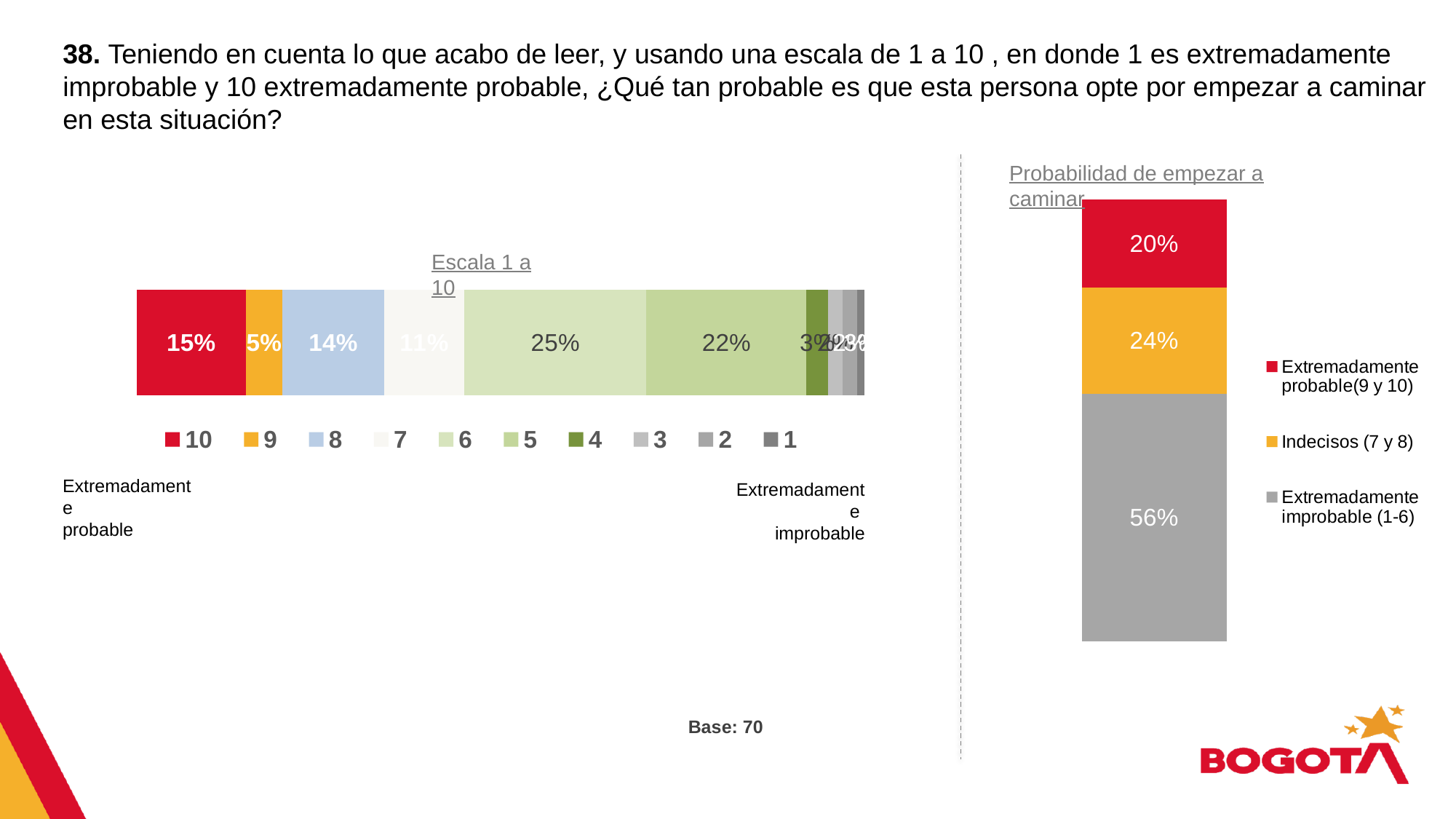
In the 'Probabilidad de empezar a caminar' chart, what percentage is 'Indecisos (7 y 8)'? 24% In the 'Probabilidad de empezar a caminar' chart, what is the difference between 'Indecisos (7 y 8)' and 'Extremadamente probable(9 y 10)'? 4% In the 'Escala 1 a 10' chart, what is the difference between the shares for 6 and 5? 3% What type of chart is the 'Probabilidad de empezar a caminar' chart? Stacked bar chart In the 'Escala 1 a 10' chart, which is larger, the share for 10 or the share for 9? 10 In the 'Escala 1 a 10' chart, what percentage is shown for the value 5? 22% How many entries does the legend of the 'Escala 1 a 10' chart list? 10 In the 'Probabilidad de empezar a caminar' chart, what percentage is 'Extremadamente improbable (1-6)'? 56% In the 'Escala 1 a 10' chart, what percentage is shown for the value 8? 14% In the 'Escala 1 a 10' chart, what percentage is shown for the value 6? 25% In the 'Escala 1 a 10' chart, what percentage is shown for the value 10? 15% In the 'Escala 1 a 10' chart, which scale value has the largest share? 6